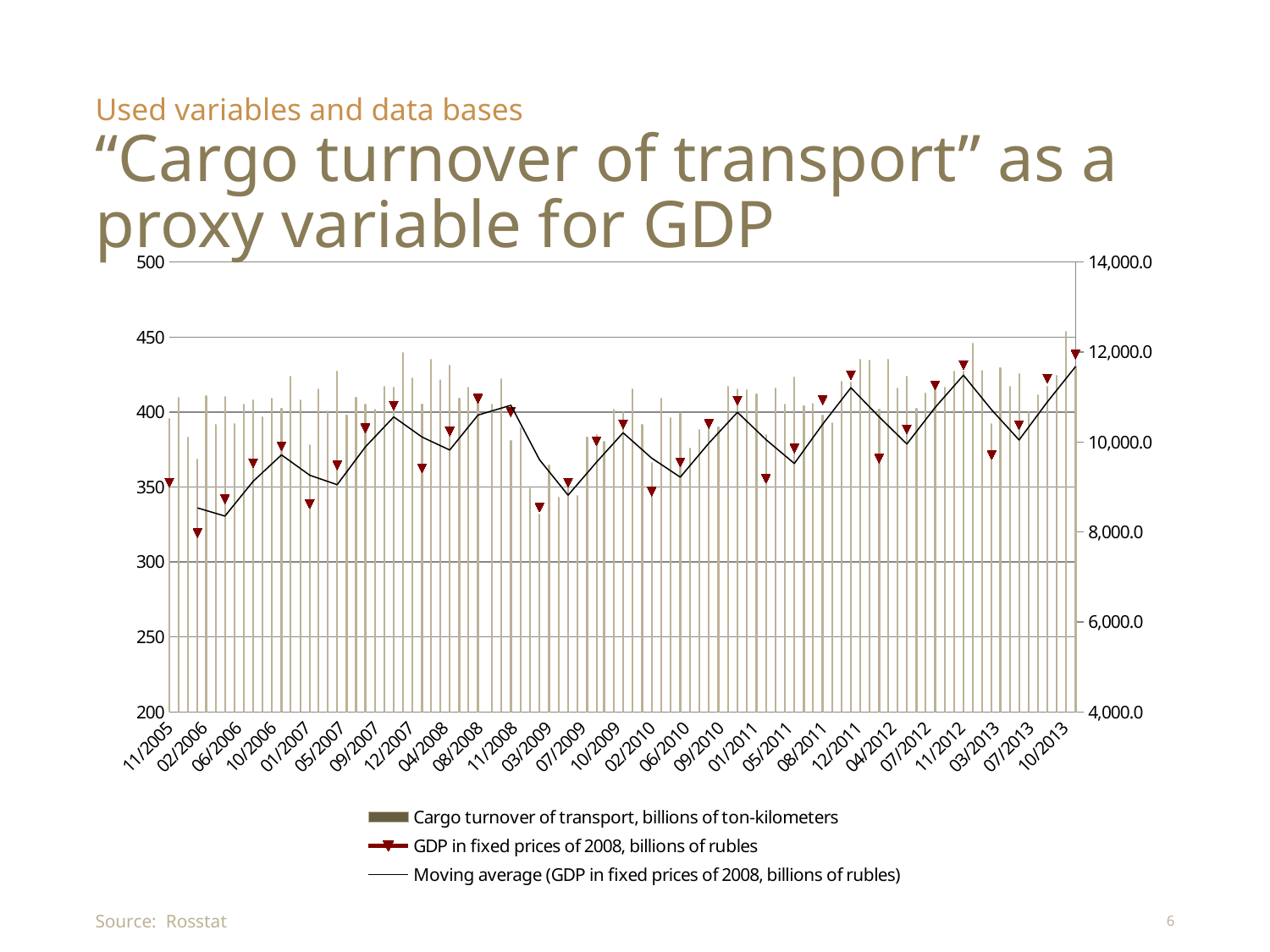
What is the source given for the chart data? Rosstat How many series does the chart legend list? 3 Overall, do the GDP in fixed prices of 2008 values rise or fall from 11/2005 to 10/2013? rise Is the GDP in fixed prices of 2008 value for 03/2009 greater or less than 10,000.0? less Is the GDP in fixed prices of 2008 value for 11/2012 greater or less than 10,000.0? greater Which series is plotted as bars in the chart? Cargo turnover of transport, billions of ton-kilometers Does the moving average line rise or fall between 11/2008 and 07/2009? fall What kind of chart is shown on the slide? A combination chart of bars and lines Is the cargo turnover of transport bar for 10/2013 greater or less than 400? greater What is the highest value shown on the right-hand axis of the chart? 14,000.0